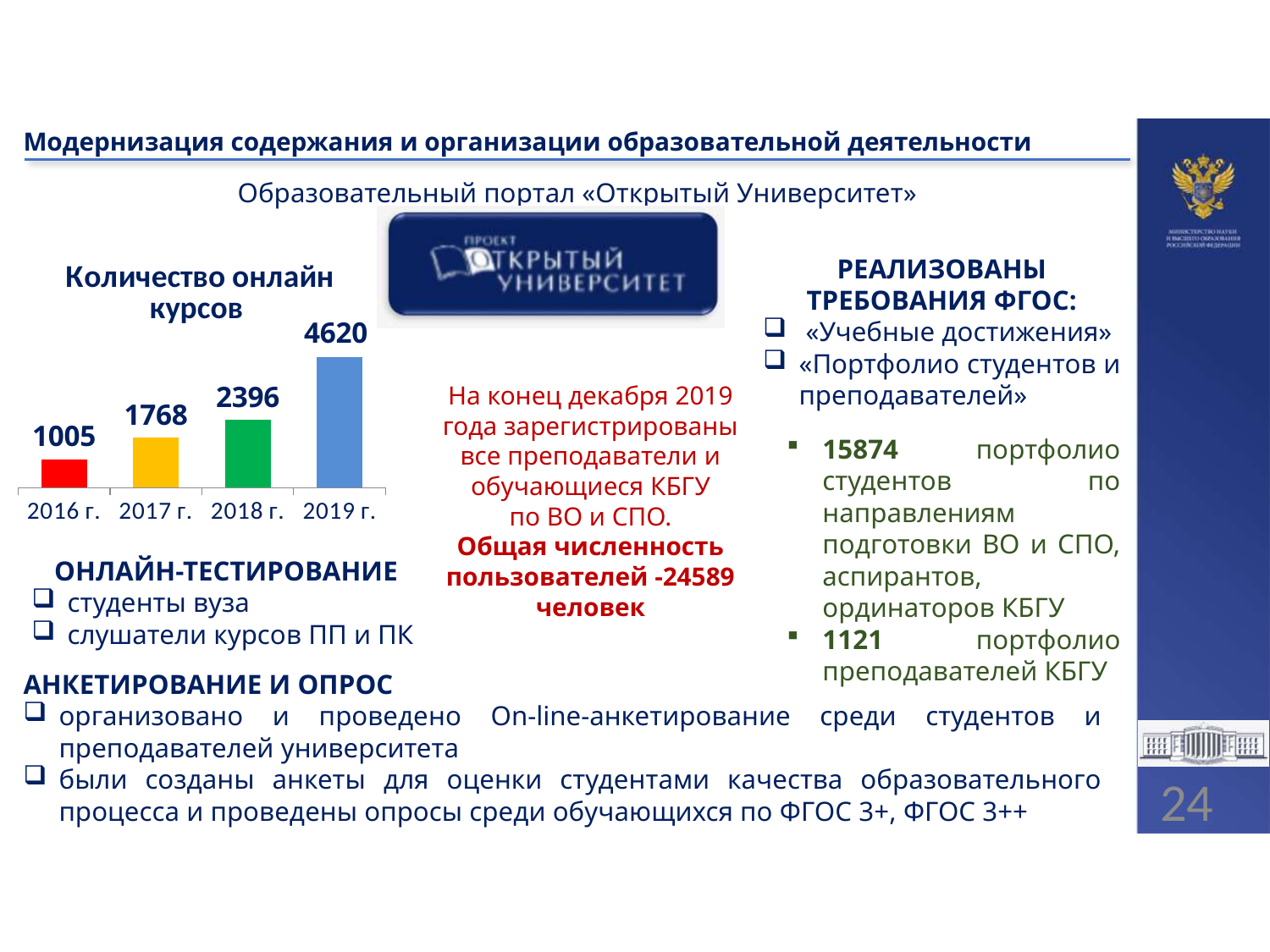
Which year has the highest number of online courses? 2019 г. Does the number of online courses rise or fall from 2016 г. to 2019 г.? Rise Which year has more online courses, 2017 г. or 2018 г.? 2018 г. What type of chart is used to show the number of online courses? Bar chart Which year has the lowest number of online courses? 2016 г. What is the number of online courses shown for 2018 г.? 2396 How many years are shown in the chart? 4 What is the difference between the number of online courses in 2017 г. and 2016 г.? 763 What is the number of online courses shown for 2016 г.? 1005 What is the number of online courses shown for 2017 г.? 1768 What is the difference between the number of online courses in 2019 г. and 2018 г.? 2224 What is the number of online courses shown for 2019 г.? 4620